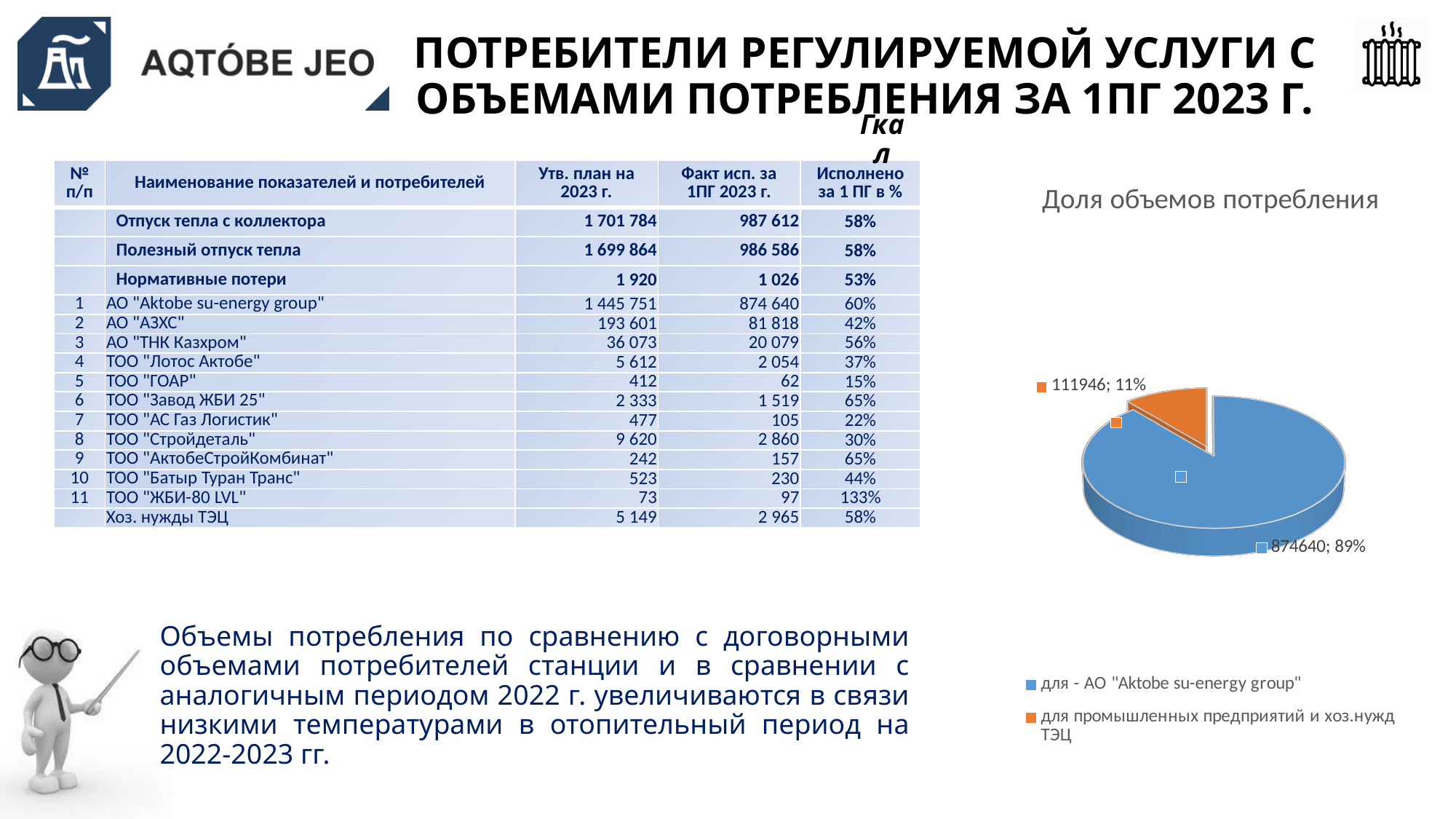
How many entries does the legend of the pie chart list? 2 What share of the pie does АО "Aktobe su-energy group" account for? 89% In the pie chart, what is the difference between the value for АО "Aktobe su-energy group" and the value for промышленных предприятий и хоз.нужд ТЭЦ? 762694 What is the title of the pie chart on the slide? Доля объемов потребления What colour is the slice for промышленных предприятий и хоз.нужд ТЭЦ in the pie chart? Orange What type of chart is shown under the title "Доля объемов потребления"? Pie chart How many slices does the pie chart "Доля объемов потребления" have? 2 In the pie chart, what value is shown for промышленных предприятий и хоз.нужд ТЭЦ? 111946 In the pie chart, what value is shown for АО "Aktobe su-energy group"? 874640 What share of the pie do промышленные предприятия и хоз.нужды ТЭЦ account for? 11% Which slice of the pie chart is the smallest? для промышленных предприятий и хоз.нужд ТЭЦ Which slice of the pie chart is the largest? для - АО "Aktobe su-energy group"